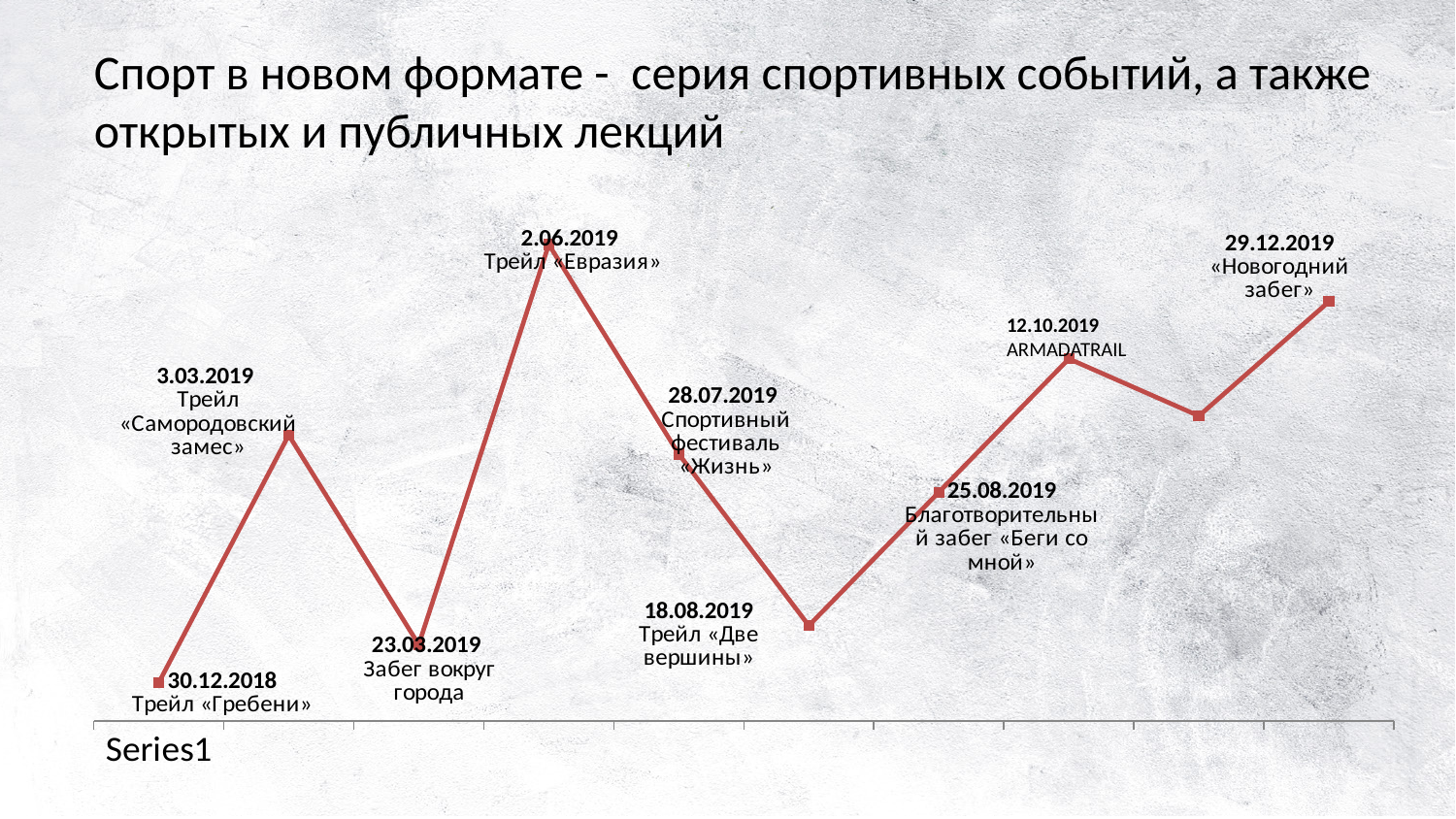
What event label is shown for the last point on the right of the line? 29.12.2019 «Новогодний забег» Which point is higher on the chart: 12.10.2019 ARMADATRAIL or 25.08.2019 Благотворительный забег «Беги со мной»? 12.10.2019 ARMADATRAIL What colour is the plotted line? red Which event is plotted at the highest point on the line? 2.06.2019 Трейл «Евразия» Which point is higher on the chart: 2.06.2019 Трейл «Евразия» or 3.03.2019 Трейл «Самородовский замес»? 2.06.2019 Трейл «Евразия» Which event is plotted at the lowest point on the line? 30.12.2018 Трейл «Гребени» What event label is shown for the first point on the left of the line? 30.12.2018 Трейл «Гребени» What kind of chart is shown on the slide? line chart How many data points are plotted on the line? 10 Which point is lower on the chart: 23.03.2019 Забег вокруг города or 28.07.2019 Спортивный фестиваль «Жизнь»? 23.03.2019 Забег вокруг города